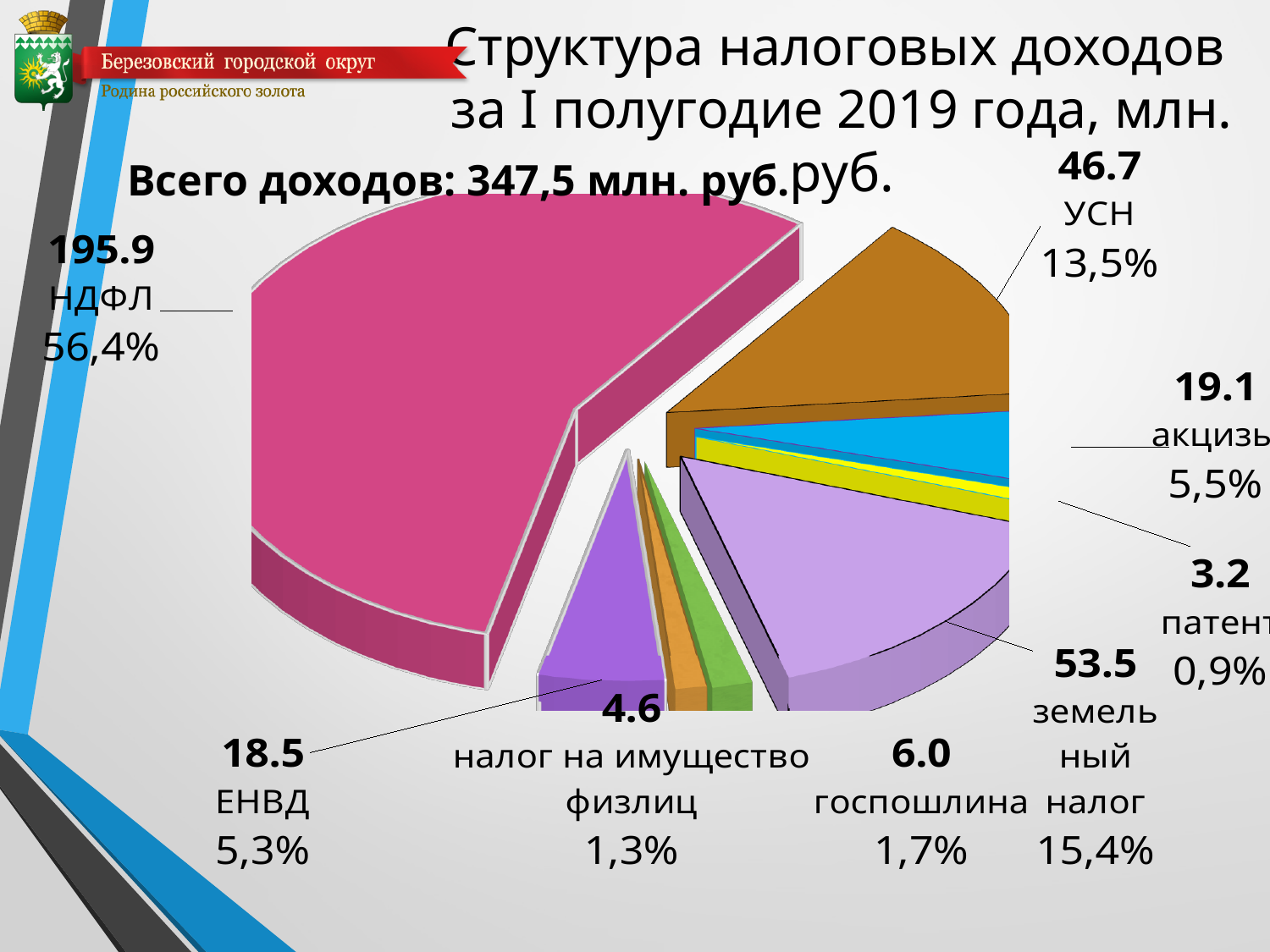
How many categories are shown on the pie chart? 8 Which category has the smallest slice of the pie? патент Which is larger, the value for ЕНВД or the value for госпошлина? ЕНВД What is the difference between the values for УСН and акцизы? 27.6 What value is shown for земельный налог? 53.5 Which category has the largest slice of the pie? НДФЛ What value is shown for НДФЛ on the pie chart? 195.9 What share of the pie does УСН account for? 13,5% What kind of chart is shown on the slide? pie chart What total revenue figure is stated on the slide? 347,5 млн. руб. What share of the pie does налог на имущество физлиц account for? 1,3% What percentage share is shown for патент? 0,9%